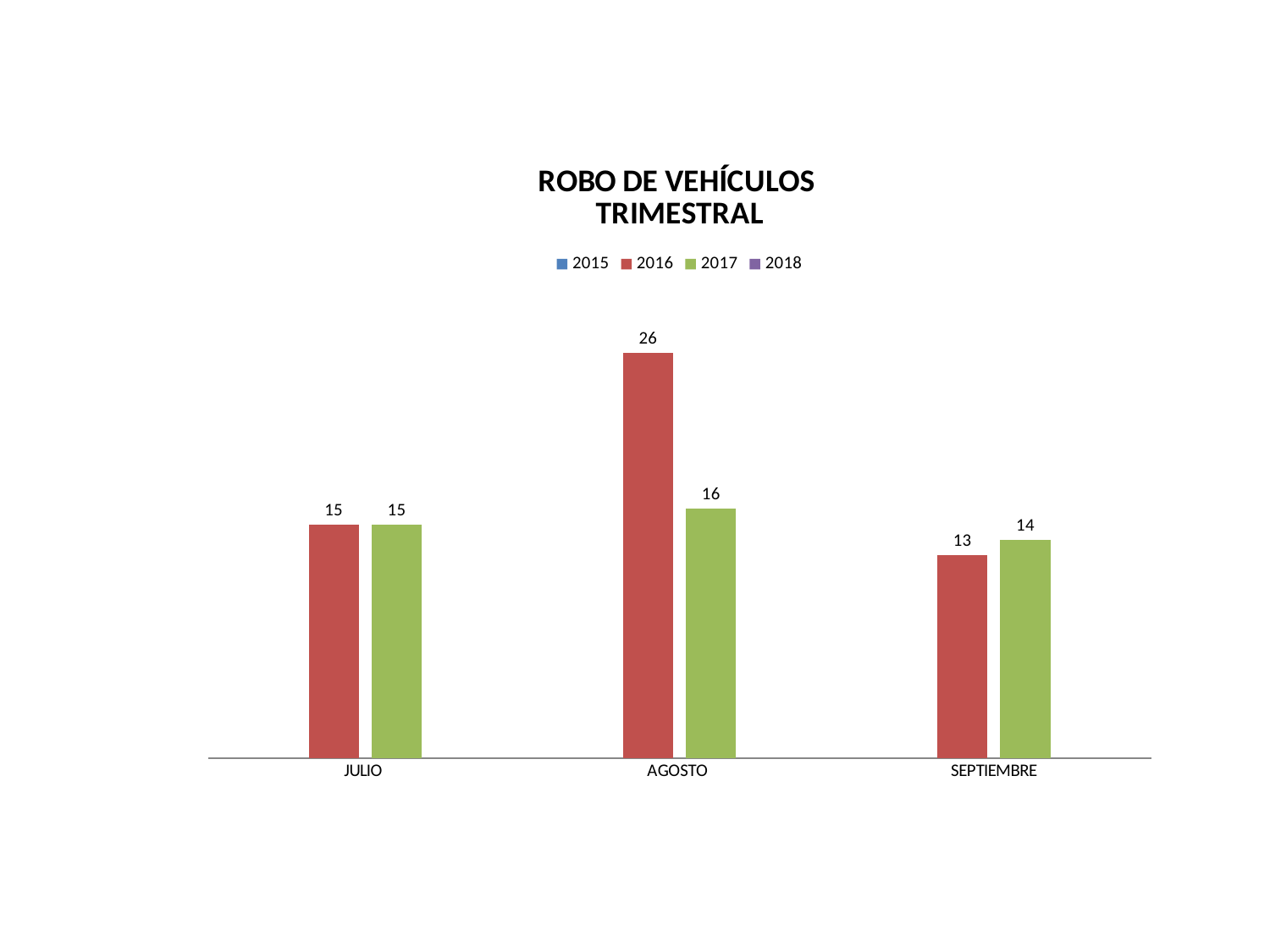
In which month is the 2016 value highest? AGOSTO Which is larger in SEPTIEMBRE, the 2016 value or the 2017 value? 2017 What is the title of the chart? ROBO DE VEHÍCULOS TRIMESTRAL What is the value for 2017 in SEPTIEMBRE? 14 What kind of chart is shown? bar chart What is the value for 2017 in AGOSTO? 16 What is the value for 2016 in AGOSTO? 26 In which month is the 2016 value lowest? SEPTIEMBRE What is the value for 2016 in JULIO? 15 What is the difference between the 2016 and 2017 values in AGOSTO? 10 How many series does the legend list? 4 How many months are shown on the x axis? 3